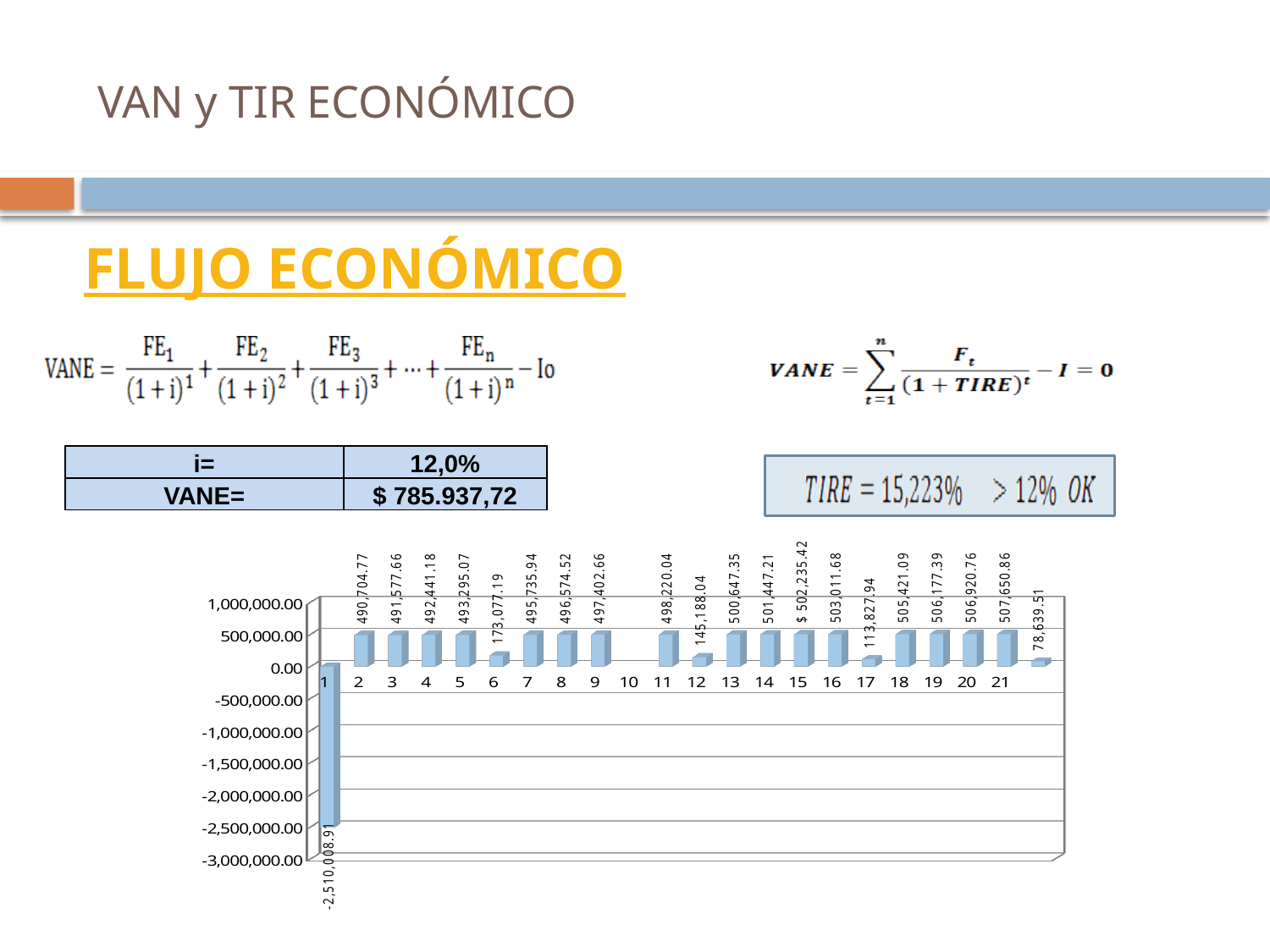
What is the value for category 12 in the chart? 145,188.04 Which category has the lowest value in the chart? 1 What is the difference between the values for category 2 and category 6? 317,627.58 What kind of chart is shown on the slide? bar chart What is the lowest value shown on the vertical axis of the chart? -3,000,000.00 What is the value for category 1 in the chart? -2,510,008.91 What is the value for category 6 in the chart? 173,077.19 What is the highest value labelled in the chart? 507,650.86 Is the value for category 1 greater or less than -2,000,000.00? less Which is larger, the value for category 6 or the value for category 12? category 6 What is the value for category 2 in the chart? 490,704.77 What is the value for category 17 in the chart? 113,827.94